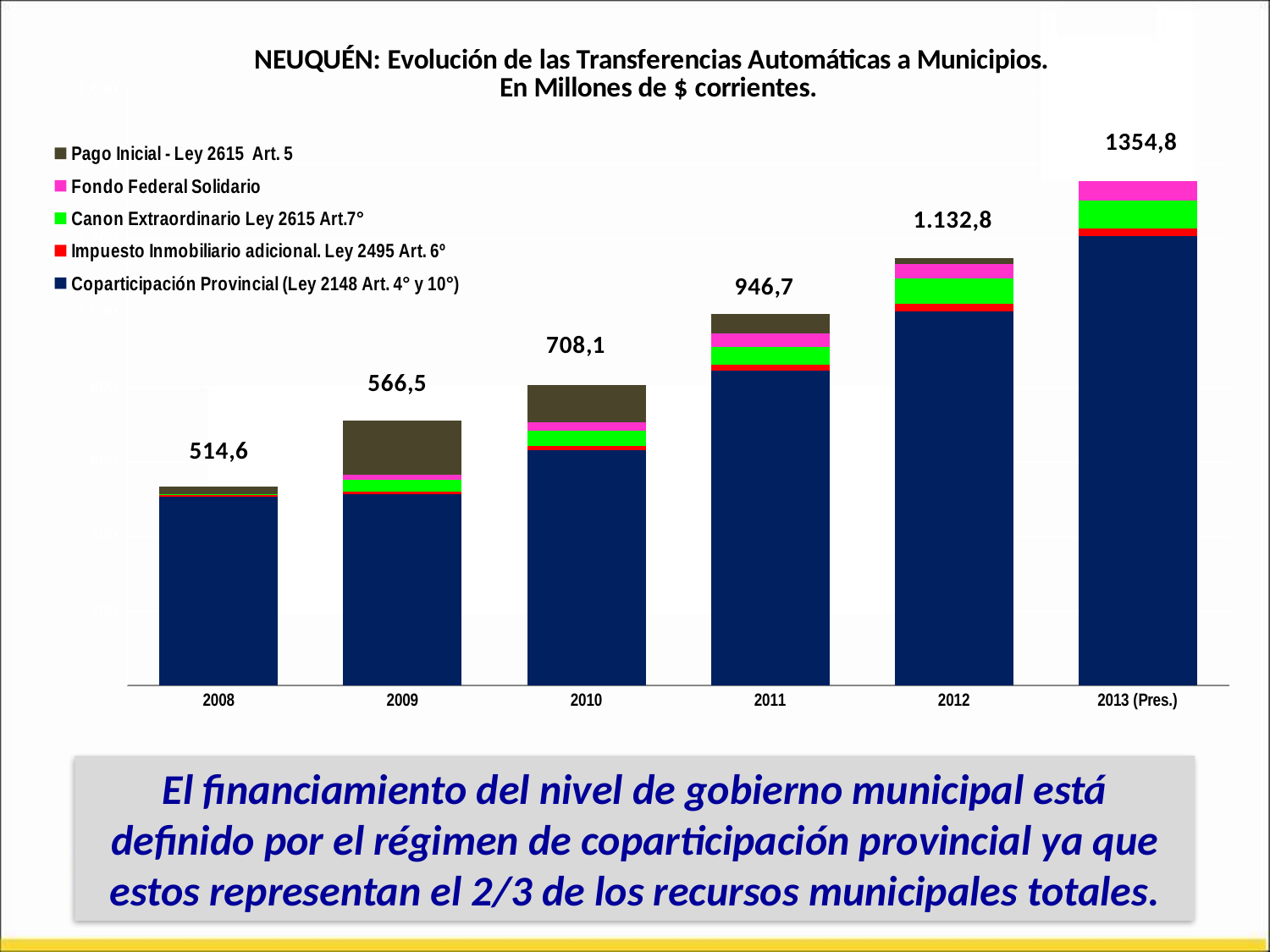
What is the total value shown for 2013 (Pres.)? 1354,8 Which year has the lowest total transfers? 2008 Do the total transfers rise or fall from 2008 to 2013 (Pres.)? Rise What kind of chart is shown on the slide? Stacked bar chart Which is larger, the total for 2010 or the total for 2011? 2011 What is the difference between the totals for 2009 and 2008? 51,9 Which year has the highest total transfers? 2013 (Pres.) How many years are shown on the x axis? 6 What is the difference between the totals for 2011 and 2010? 238,6 What is the total value shown for 2012? 1.132,8 What is the total value shown for 2008? 514,6 How many series does the legend list? 5